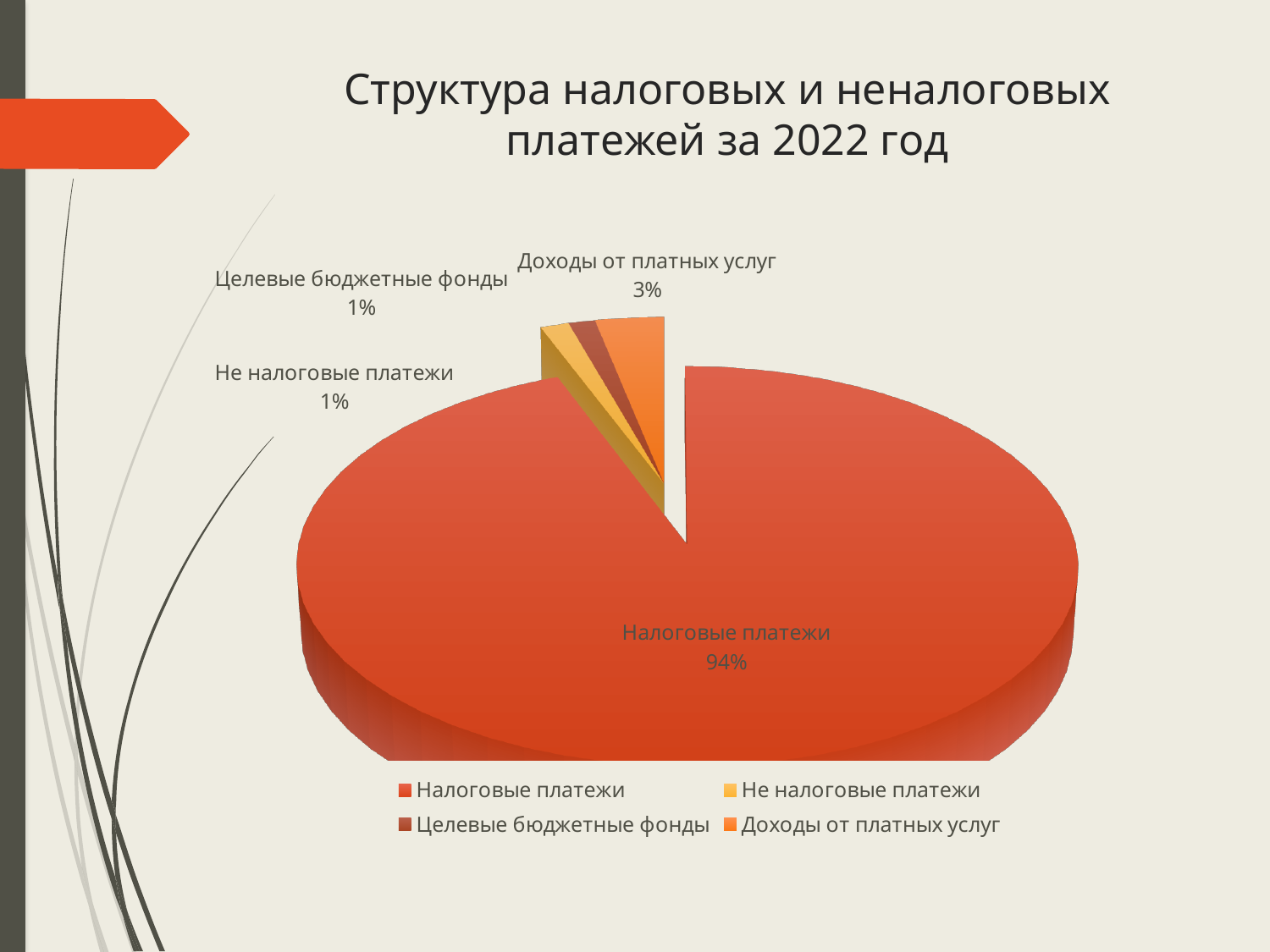
What kind of chart is shown on the slide? pie chart Which category has the largest slice of the pie? Налоговые платежи What share of the pie does Не налоговые платежи have? 1% What share of the pie does Целевые бюджетные фонды have? 1% How many categories does the pie chart show? 4 What share of the pie does Доходы от платных услуг have? 3% How many entries does the legend list? 4 Which is larger, the share for Доходы от платных услуг or the share for Целевые бюджетные фонды? Доходы от платных услуг What is the difference in percentage points between Доходы от платных услуг and Не налоговые платежи? 2% What is the difference in percentage points between Налоговые платежи and Доходы от платных услуг? 91% What is the title of the chart? Структура налоговых и неналоговых платежей за 2022 год